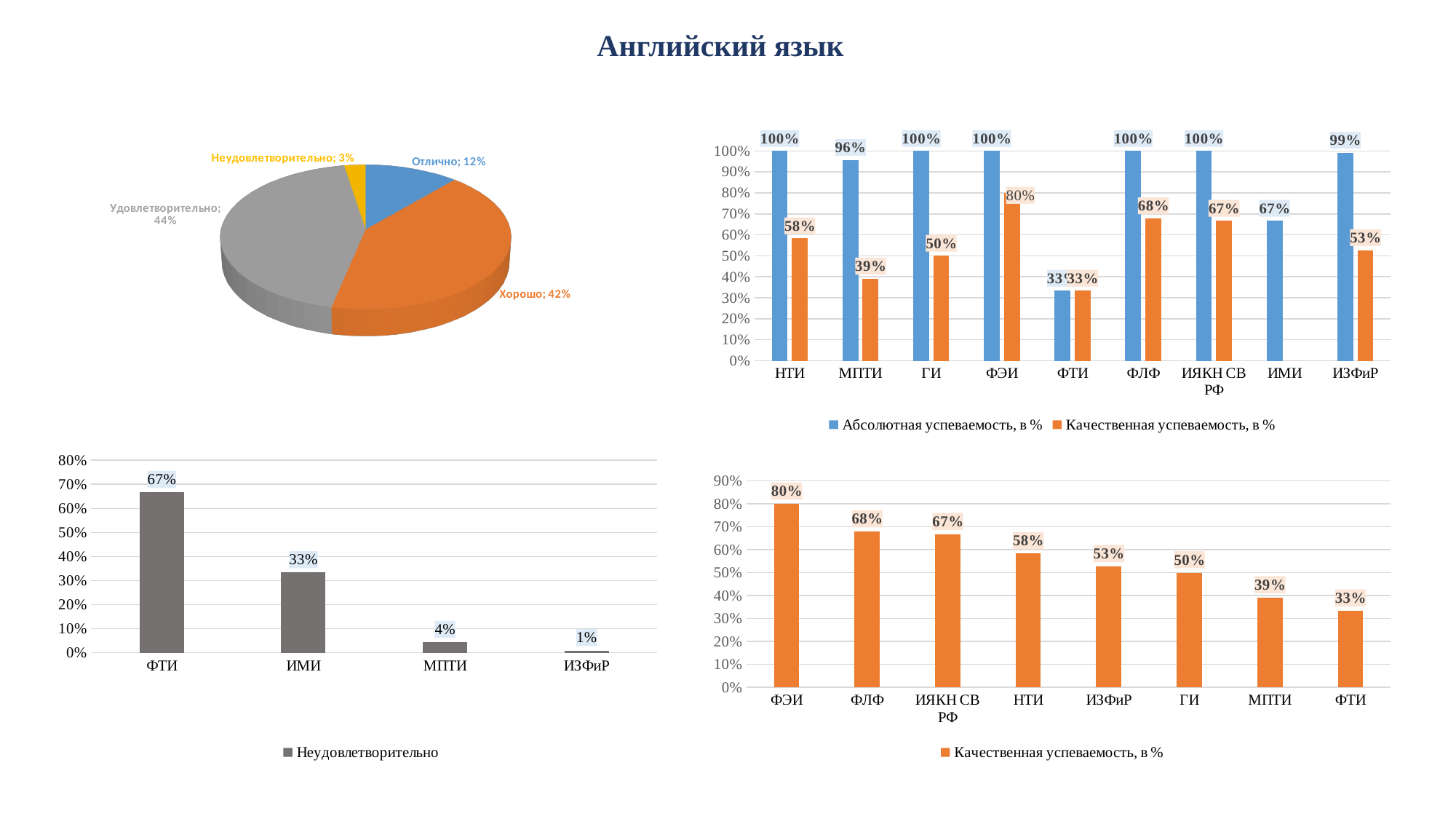
In the pie chart at the top left, which category has the smallest slice? Неудовлетворительно In the bar chart at the bottom left, how many categories are shown? 4 In the bar chart at the bottom left, which category has the highest value? ФТИ In the pie chart at the top left, what share is labelled Хорошо? 42% In the grouped bar chart at the top right, what is the value of Абсолютная успеваемость for МПТИ? 96% In the bar chart at the bottom right, which is larger, the value for ФЛФ or the value for НТИ? ФЛФ In the grouped bar chart at the top right, what is the value of Качественная успеваемость for ФЭИ? 80% In the bar chart at the bottom right, do the values rise or fall from left to right along the x axis? fall In the grouped bar chart at the top right, how many series does the legend list? 2 In the bar chart at the bottom left, what is the value for ИМИ? 33% In the pie chart at the top left, how many slices are there? 4 In the grouped bar chart at the top right, what is the difference between Абсолютная успеваемость and Качественная успеваемость for ГИ? 50%